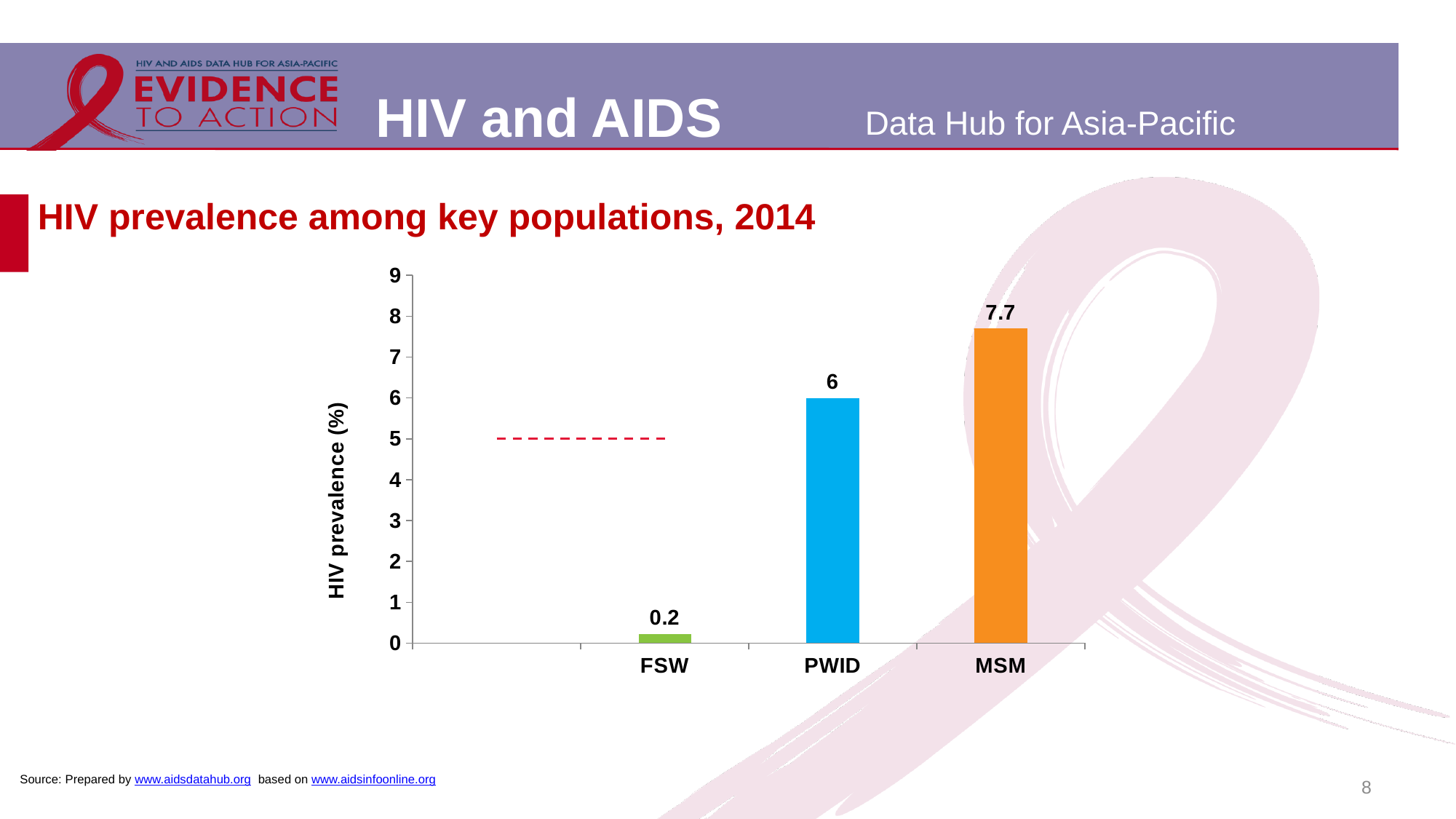
Is the HIV prevalence for MSM greater or less than 5? greater What is the HIV prevalence (%) for PWID? 6 What kind of chart is shown on the slide? bar chart What is the HIV prevalence (%) for FSW? 0.2 Which key population has the lowest HIV prevalence? FSW Which key population has the highest HIV prevalence? MSM Which has a higher HIV prevalence, PWID or FSW? PWID What is the difference in HIV prevalence between PWID and FSW? 5.8 What is the HIV prevalence (%) for MSM? 7.7 What is the difference in HIV prevalence between MSM and PWID? 1.7 How many key populations are shown in the chart? 3 What is the label of the vertical axis of the chart? HIV prevalence (%)